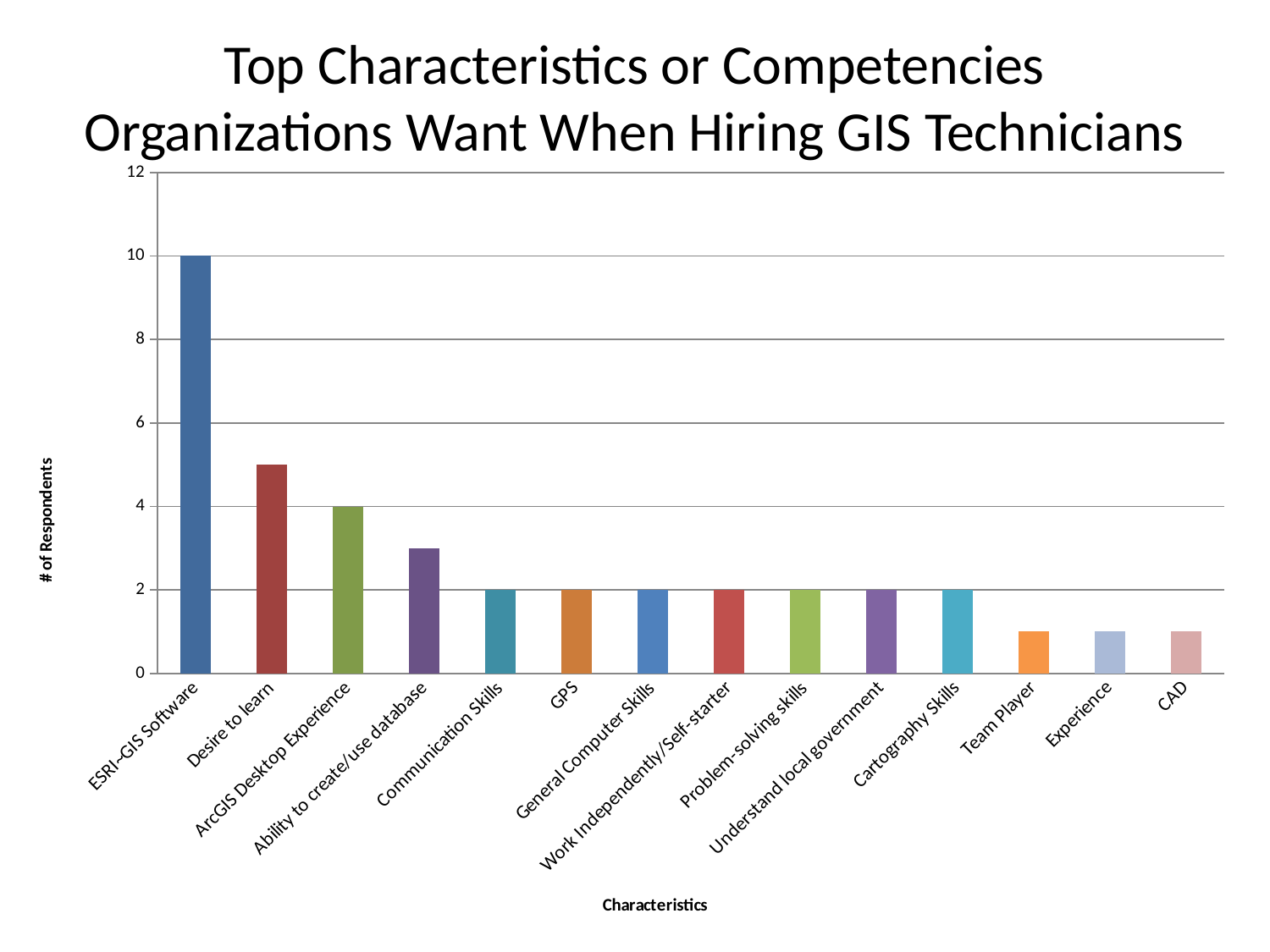
Do the values generally rise or fall moving from left to right along the x axis? Fall Which has more respondents, Desire to learn or ArcGIS Desktop Experience? Desire to learn Is the value for Ability to create/use database greater or less than 2? greater What type of chart is shown on the slide? Bar chart How many respondents selected ESRI-GIS Software? 10 How many respondents selected ArcGIS Desktop Experience? 4 How many characteristics are shown on the x axis? 14 Is the value for Team Player greater or less than 2? less How many respondents selected Communication Skills? 2 What is the difference in respondents between ESRI-GIS Software and ArcGIS Desktop Experience? 6 Which characteristic has the highest number of respondents? ESRI~GIS Software Is the value for Desire to learn greater or less than 4? greater